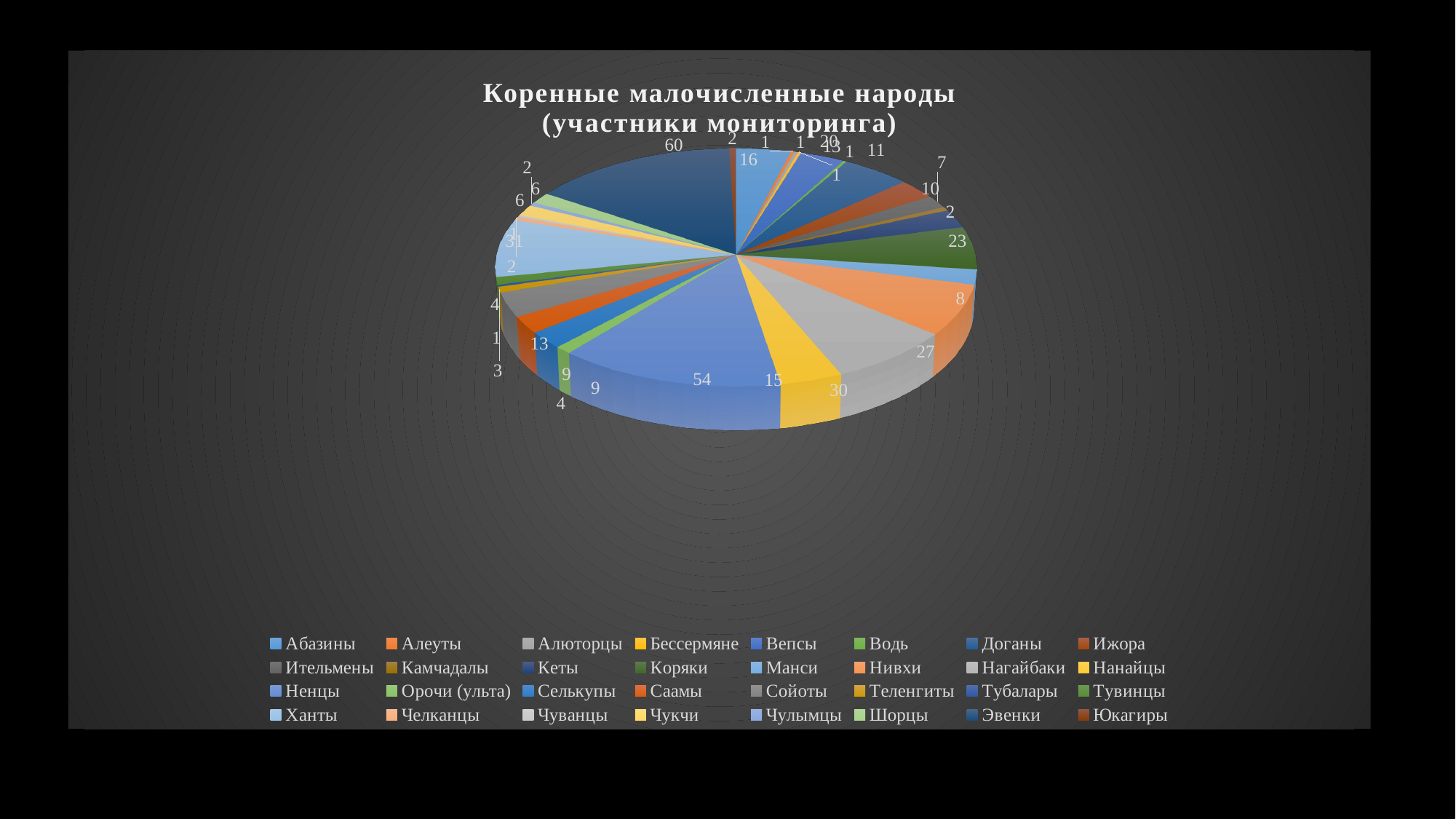
What is the value for Коряки? 23 Which is larger, the value for Эвенки or the value for Ненцы? Эвенки What is the title of the chart? Коренные малочисленные народы (участники мониторинга) What is the value for Ненцы? 54 What is the smallest value labelled on the pie chart? 1 What type of chart is shown on the slide? pie chart What is the value for Эвенки? 60 What is the difference between the values for Эвенки and Ненцы? 6 What is the value for Абазины? 16 Which category is listed first in the legend? Абазины How many categories does the legend list? 32 What is the largest value labelled on the pie chart? 60